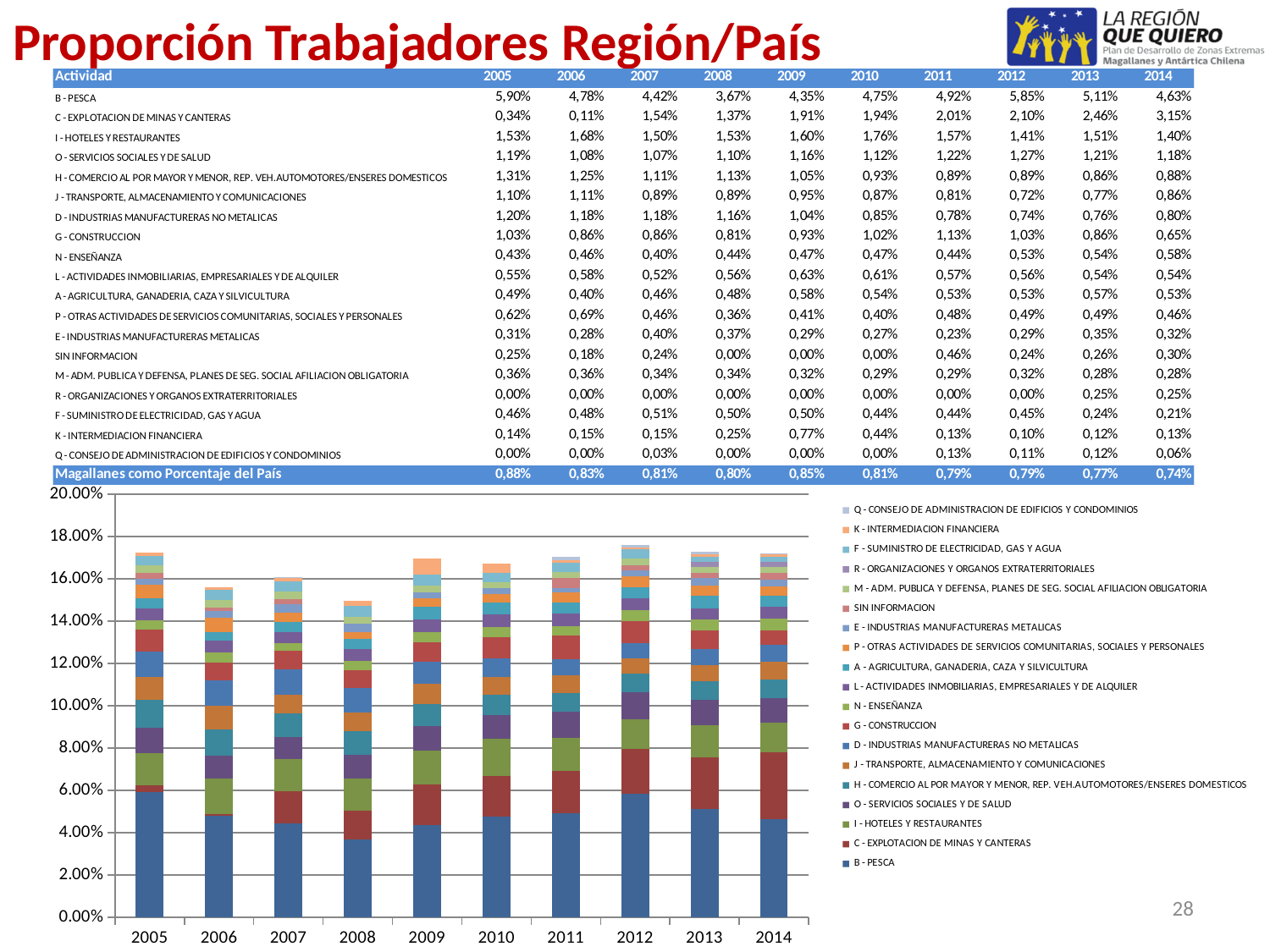
What kind of chart is shown at the bottom of the slide? Stacked bar chart What is the value for C - EXPLOTACION DE MINAS Y CANTERAS in 2014? 3,15% How many series does the legend of the stacked bar chart list? 19 Which series forms the bottom segment of each stacked bar in the chart? B - PESCA Is the total height of the stacked bar for 2012 greater or less than 16.00%? greater Is the total height of the stacked bar for 2005 greater or less than 16.00%? greater What is the difference between the B - PESCA values for 2005 and 2008? 2,23% How many years are shown along the x axis of the stacked bar chart? 10 Is the total height of the stacked bar for 2008 greater or less than 16.00%? less Which year has the lowest stacked bar in the chart? 2008 Which year has the larger value for B - PESCA, 2012 or 2013? 2012 What is the value for B - PESCA in 2005? 5,90%